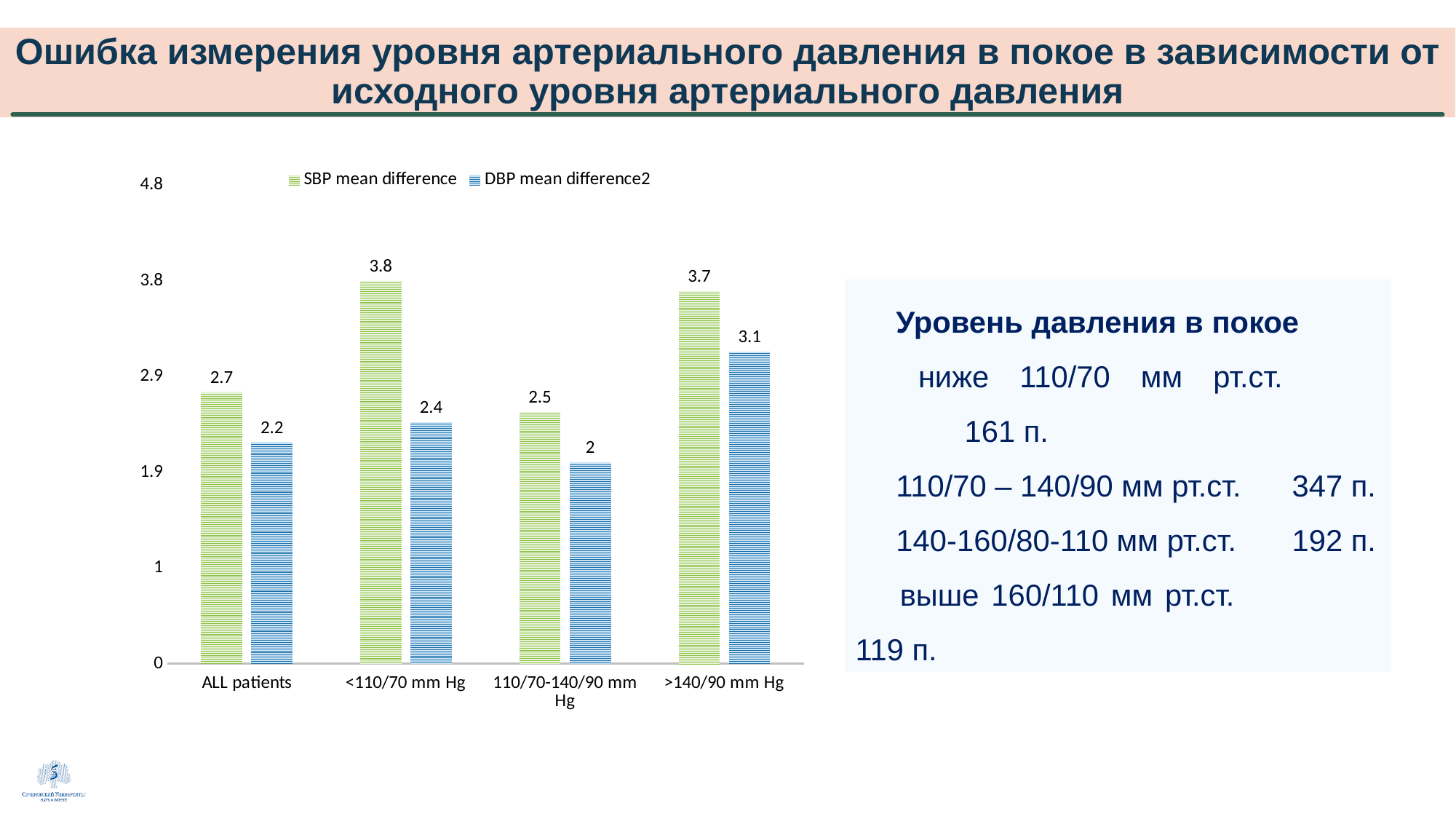
What is the total of the SBP mean difference and DBP mean difference2 values for ALL patients? 4.9 Which category has the highest SBP mean difference? <110/70 mm Hg What is the SBP mean difference for ALL patients? 2.7 Which category has the lowest DBP mean difference2? 110/70-140/90 mm Hg How many series does the chart legend list? 2 What is the DBP mean difference2 value for the >140/90 mm Hg category? 3.1 How many categories are shown on the x axis of the chart? 4 What is the difference between the SBP mean difference and the DBP mean difference2 for the <110/70 mm Hg category? 1.4 What are the two series names listed in the chart legend? SBP mean difference and DBP mean difference2 What is the DBP mean difference2 value for the 110/70-140/90 mm Hg category? 2 Which is larger for the >140/90 mm Hg category: the SBP mean difference or the DBP mean difference2? SBP mean difference What kind of chart is shown on the slide? bar chart